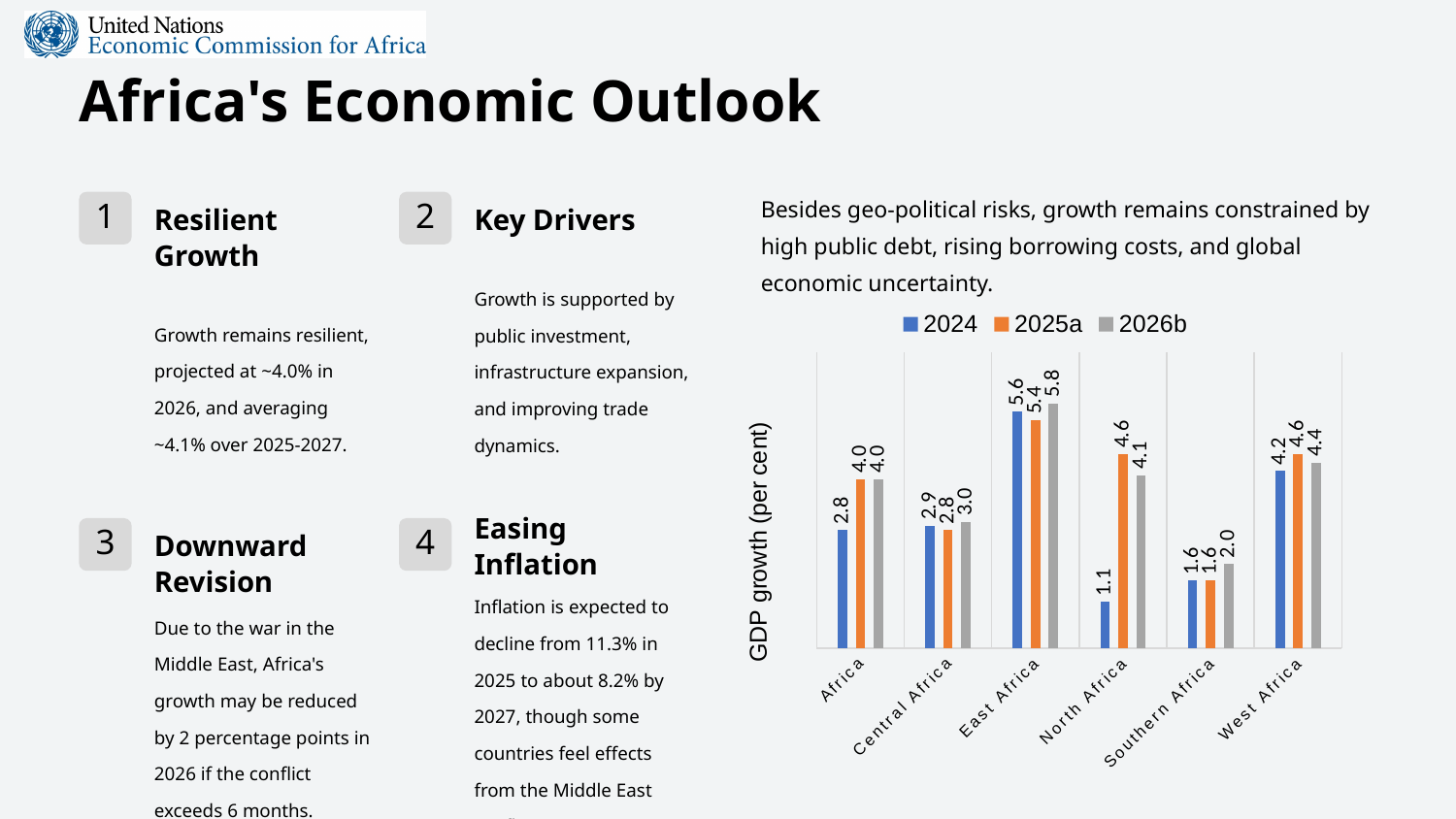
What is the 2025a GDP growth value for West Africa? 4.6 What is the label of the y axis of the chart? GDP growth (per cent) Which region has the highest 2024 GDP growth value? East Africa Which is larger, the 2026b value for West Africa or the 2026b value for North Africa? West Africa Do the GDP growth values for Southern Africa rise or fall from 2024 to 2026b? Rise How many series does the chart legend list? 3 What is the 2026b GDP growth value for East Africa? 5.8 How many regions are shown on the x axis of the chart? 6 Which region has the lowest 2026b GDP growth value? Southern Africa What is the 2024 GDP growth value for North Africa? 1.1 What is the difference between the 2025a and 2024 GDP growth values for North Africa? 3.5 What kind of chart is shown on the slide? Bar chart